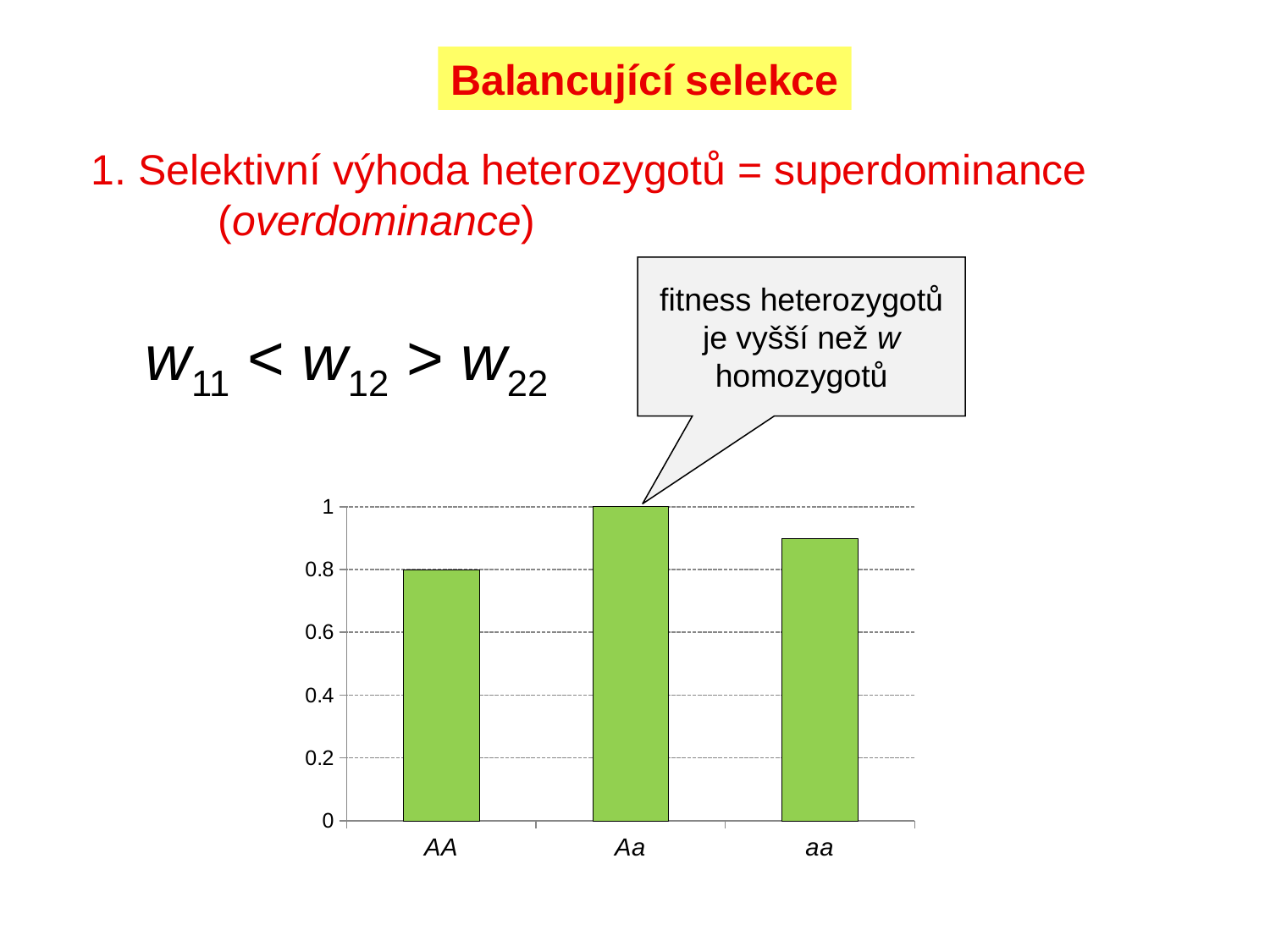
Is the value for aa greater or less than 1? less What kind of chart is shown on the slide? bar chart Which category has the highest bar? Aa What is the difference between the values for Aa and AA? 0.2 How many categories are shown on the x axis? 3 Is the value for aa greater or less than 0.8? greater What is the highest value labelled on the y axis? 1 Which is larger, the value for AA or the value for aa? aa What is the value for AA? 0.8 Which category has the lowest bar? AA What colour are the bars in the chart? green